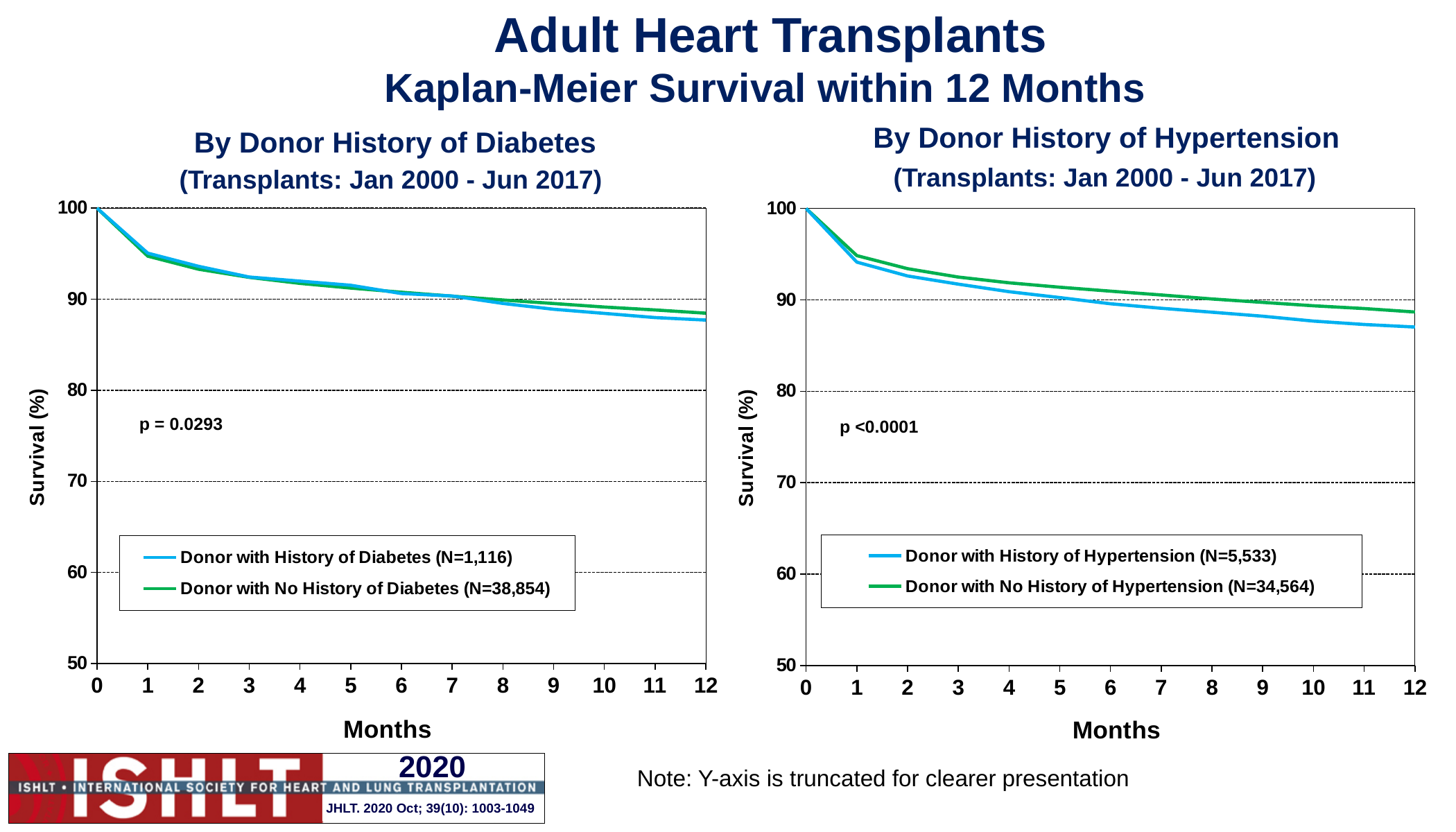
In the 'By Donor History of Hypertension' chart, which series has the higher survival at 12 months? Donor with No History of Hypertension What type of chart is used in the 'By Donor History of Diabetes' panel? Line chart In the 'By Donor History of Diabetes' chart, what is the N for Donor with History of Diabetes shown in the legend? 1,116 In the 'By Donor History of Hypertension' chart, is the survival for Donor with History of Hypertension at 6 months greater or less than 80? greater In the 'By Donor History of Hypertension' chart, is the survival for Donor with No History of Hypertension at 1 month greater or less than 90? greater In the 'By Donor History of Diabetes' chart, is the survival for Donor with History of Diabetes at 12 months greater or less than 90? less In the 'By Donor History of Diabetes' chart, what is the survival value for both series at month 0? 100 In the 'By Donor History of Hypertension' chart, how many series does the legend list? 2 What p-value is shown on the 'By Donor History of Hypertension' chart? p <0.0001 In the 'By Donor History of Diabetes' chart, do the survival curves rise or fall as months increase? Fall